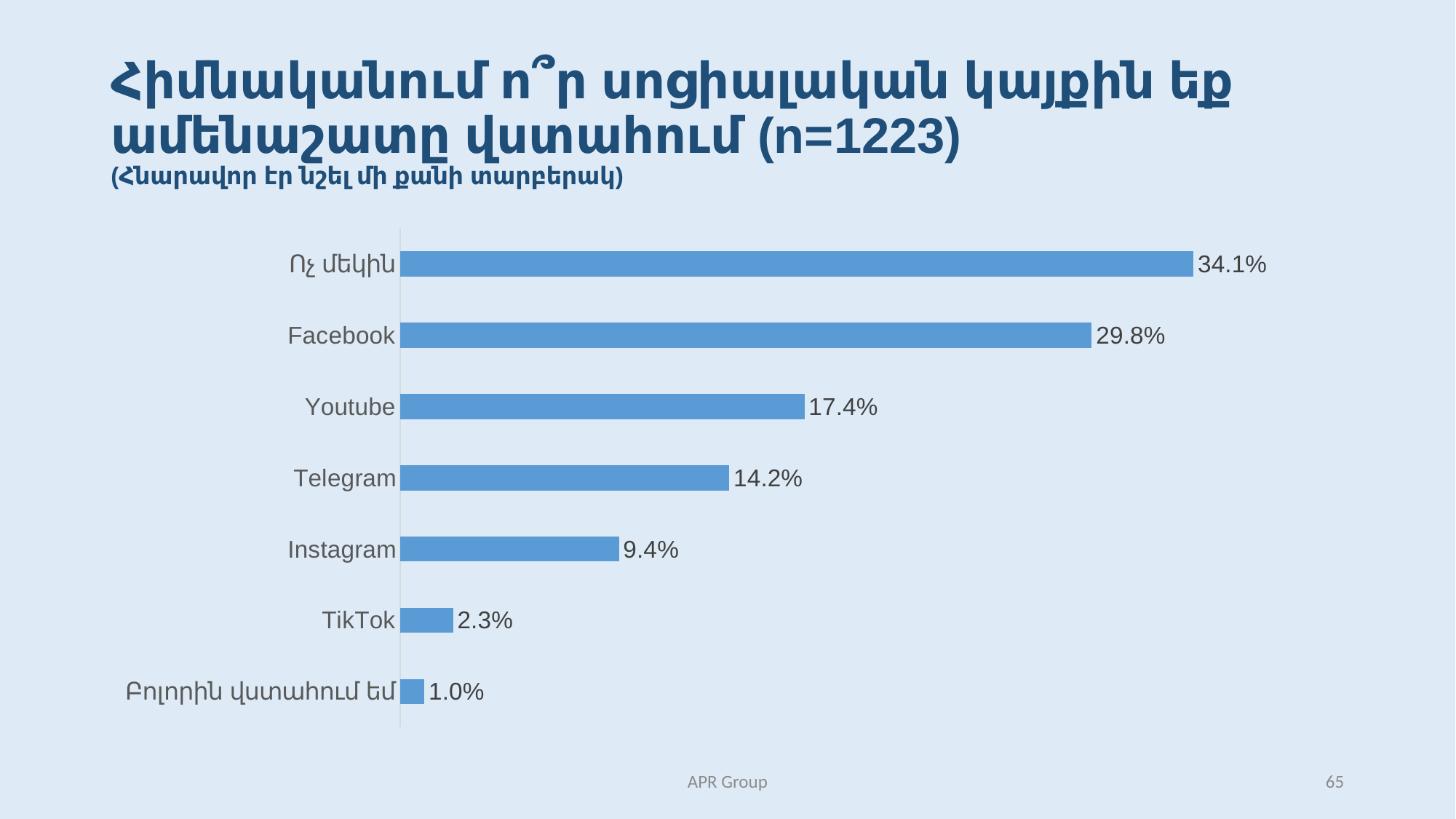
How many categories are shown in the chart? 7 Which is larger, the value for Instagram or the value for TikTok? Instagram Which category has the highest value? Ոչ մեկին What is the sample size (n) stated in the slide title? 1223 What is the difference between the values for Youtube and Telegram? 3.2% What is the value for Telegram? 14.2% What kind of chart is shown on the slide? Bar chart What is the value for Youtube? 17.4% What is the value for Facebook? 29.8% What is the difference between the values for Facebook and Instagram? 20.4% Which category has the lowest value? Բոլորին վստահում եմ What is the value for TikTok? 2.3%